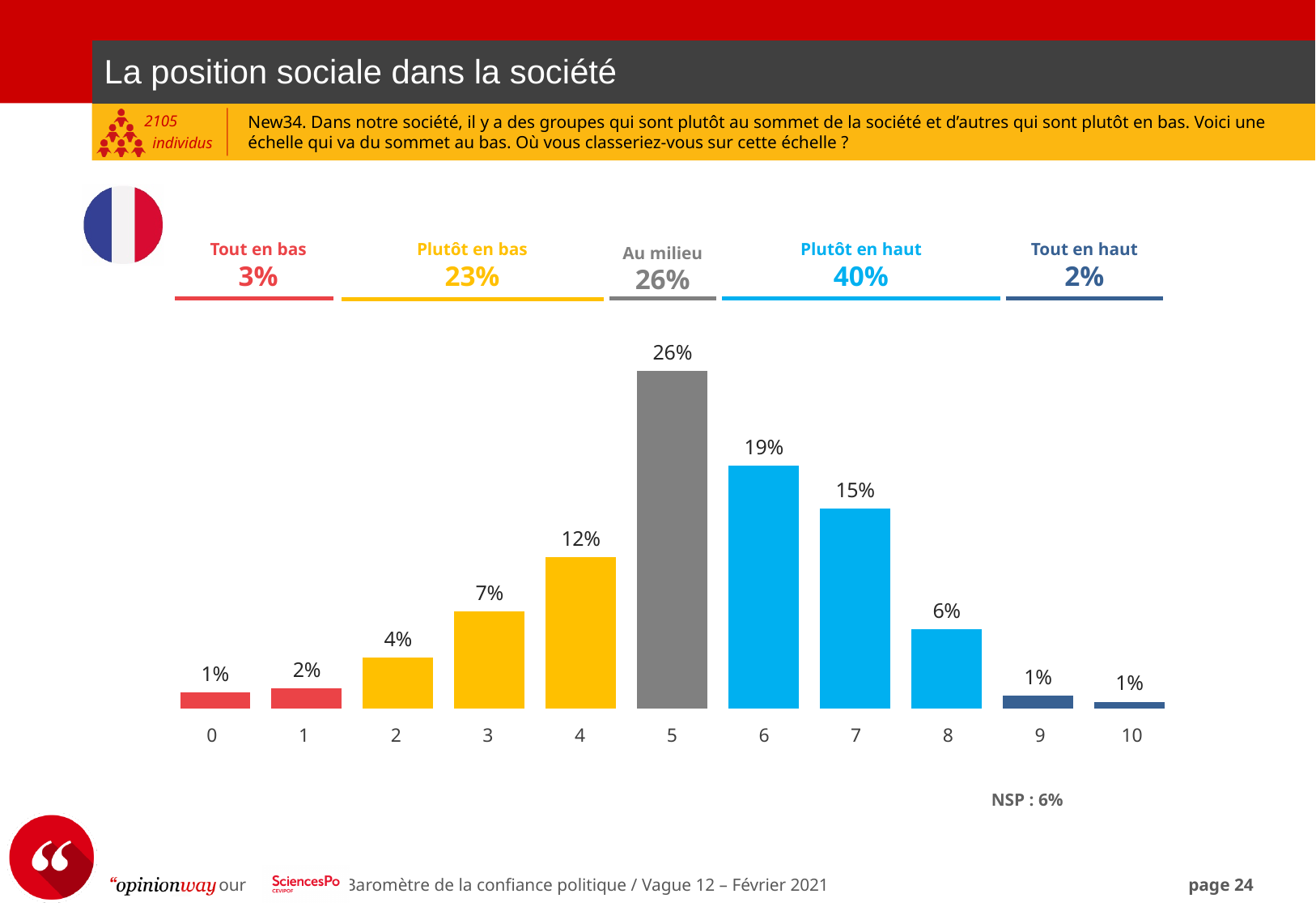
What is the difference between the values for categories 6 and 7? 4% What is the NSP value shown below the chart? 6% What is the value for category 5? 26% Which is larger, the value for category 4 or the value for category 8? 4 Which category has the highest value? 5 How many categories are shown on the x axis? 11 What kind of chart is shown? Bar chart What is the value for category 3? 7% What is the total of the values for categories 2, 3 and 4? 23% What percentage is shown for 'Plutôt en haut' in the summary above the chart? 40% What is the value for category 6? 19% Do the values rise or fall from category 0 to category 5? Rise